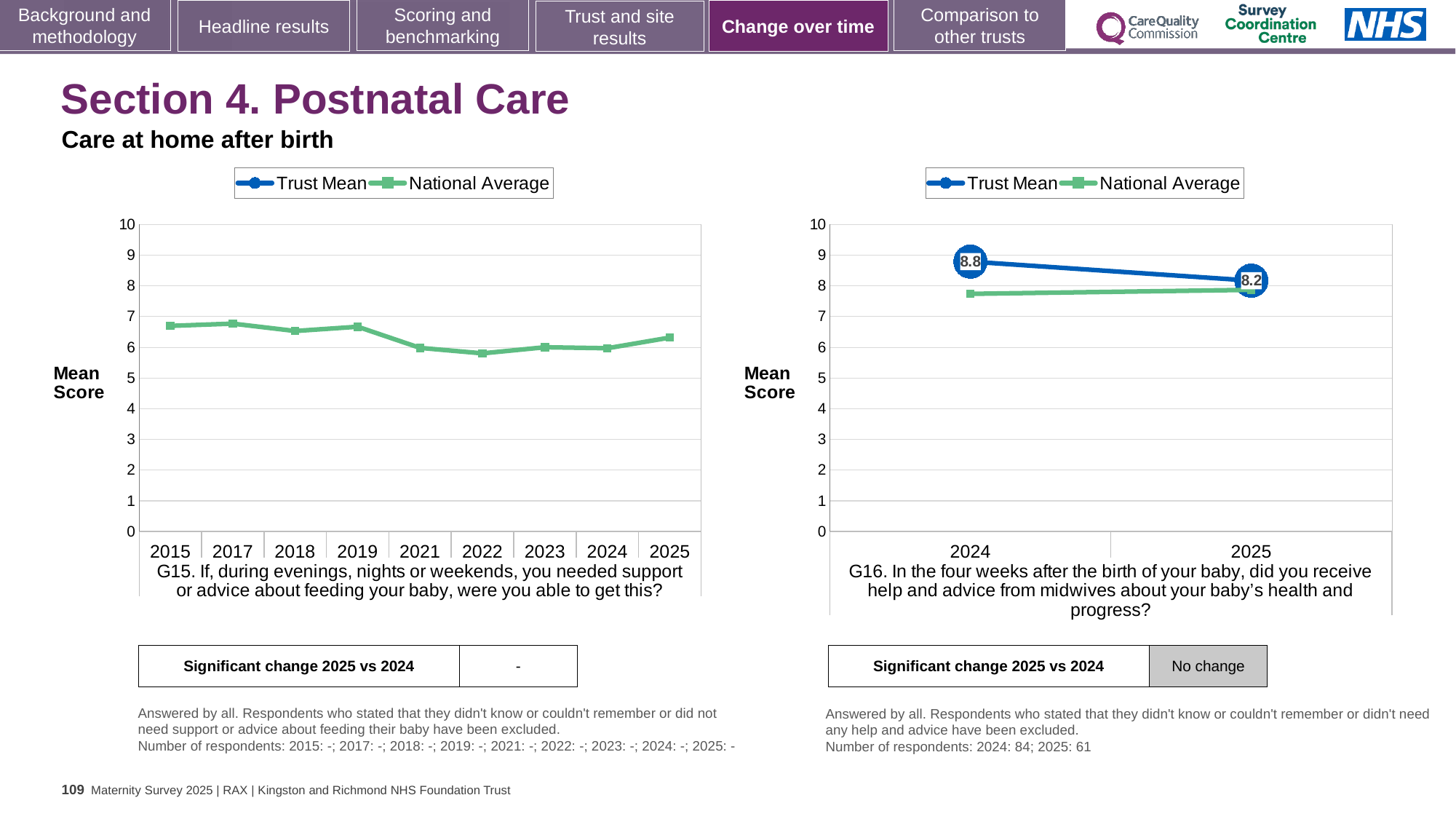
On the G16 chart (right), what is the Trust Mean score for 2024? 8.8 On the G16 chart (right), which is higher in 2024, the Trust Mean or the National Average? Trust Mean What type of chart is the G16 chart (right)? line chart On the G16 chart (right), does the Trust Mean rise or fall from 2024 to 2025? fall On the G15 chart (left), is the National Average for 2015 greater or less than 6? greater How many series does the legend of the G15 chart (left) list? 2 On the G15 chart (left), is the National Average for 2022 greater or less than 6? less On the G16 chart (right), by how much did the Trust Mean change from 2024 to 2025? 0.6 On the G15 chart (left), how many years are shown on the x axis? 9 On the G16 chart (right), how many years are shown on the x axis? 2 On the G16 chart (right), is the National Average for 2024 greater or less than 8? less On the G16 chart (right), what is the Trust Mean score for 2025? 8.2